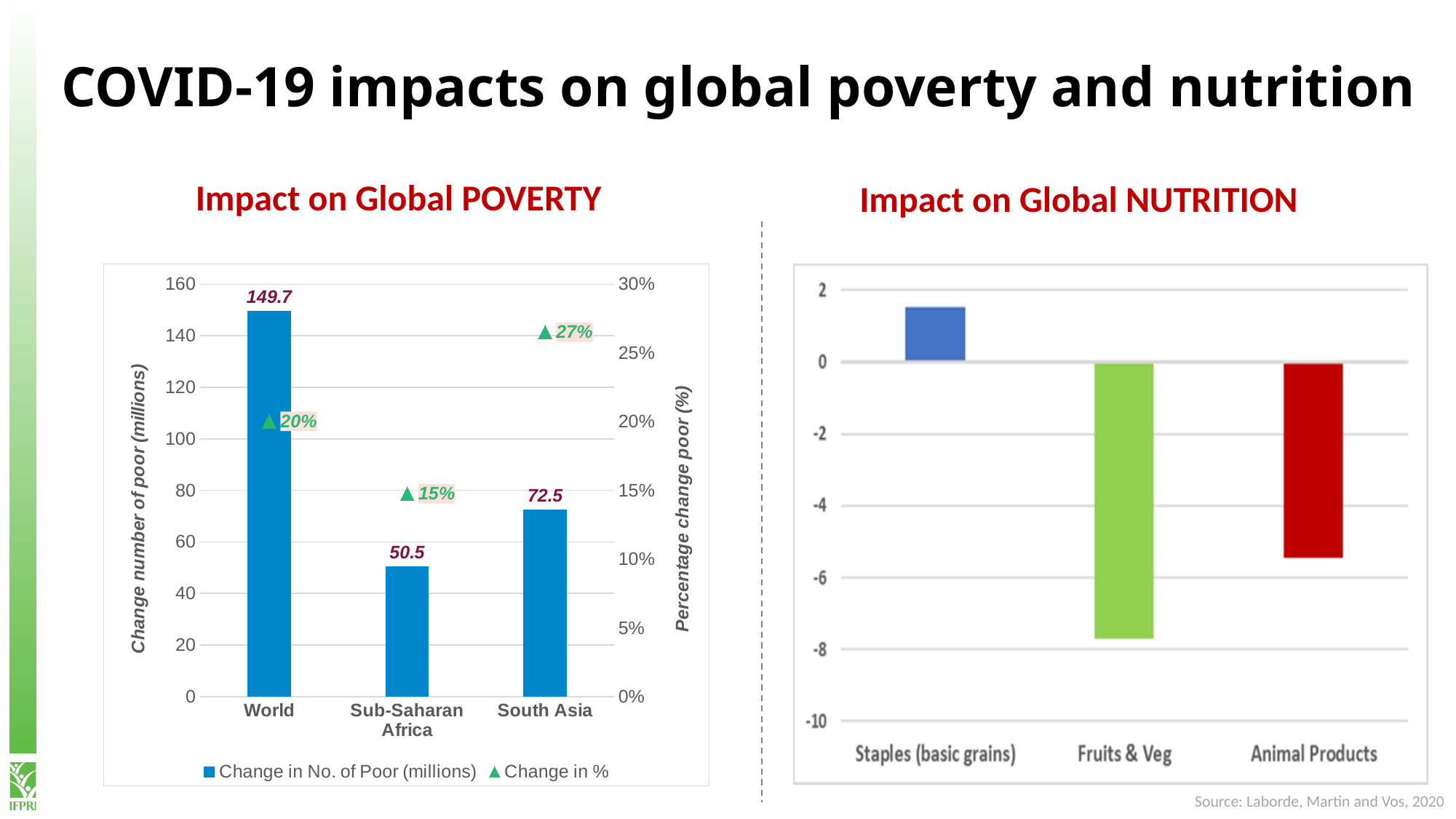
In the Impact on Global NUTRITION chart, which category has the only positive value? Staples (basic grains) In the Impact on Global POVERTY chart, what is the difference in change in number of poor (millions) between South Asia and Sub-Saharan Africa? 22.0 In the Impact on Global POVERTY chart, how many series does the legend list? 2 In the Impact on Global POVERTY chart, which category has the lowest change in number of poor (millions)? Sub-Saharan Africa In the Impact on Global POVERTY chart, what is the percentage change in poor for South Asia? 27% In the Impact on Global POVERTY chart, what is the change in number of poor (millions) for Sub-Saharan Africa? 50.5 What kind of chart is the Impact on Global NUTRITION chart? Bar chart In the Impact on Global POVERTY chart, which region has the highest percentage change in poor? South Asia In the Impact on Global NUTRITION chart, how many categories are shown? 3 In the Impact on Global NUTRITION chart, is the value for Fruits & Veg greater or less than -6? less In the Impact on Global POVERTY chart, what is the change in number of poor (millions) for World? 149.7 In the Impact on Global POVERTY chart, what is the label of the left vertical axis? Change number of poor (millions)